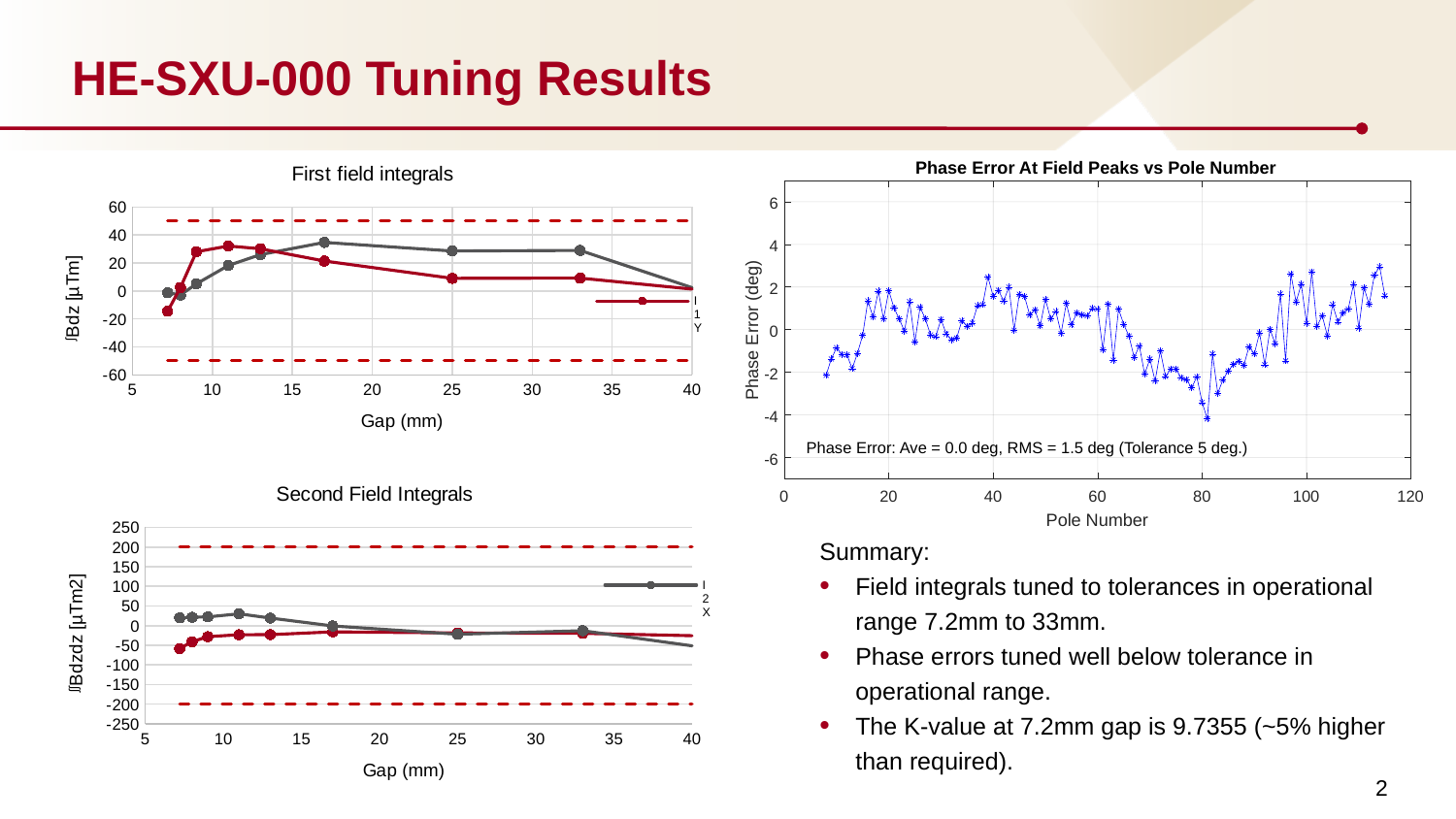
On the 'Phase Error At Field Peaks vs Pole Number' chart, what average phase error is stated in the annotation? 0.0 deg What is the x-axis label of the 'Second Field Integrals' chart? Gap (mm) On the 'First field integrals' chart, does the red series rise or fall between a gap of 11 mm and a gap of 40 mm? fall On the 'First field integrals' chart, at which y-axis values are the dashed red tolerance lines drawn? 50 and -50 On the 'Phase Error At Field Peaks vs Pole Number' chart, what RMS phase error is stated in the annotation? 1.5 deg On the 'First field integrals' chart, is the value of the red series at a gap of 7 mm greater or less than 0? less On the 'Phase Error At Field Peaks vs Pole Number' chart, what tolerance is stated in the annotation? 5 deg On the 'Phase Error At Field Peaks vs Pole Number' chart, is the phase error at pole number 81 greater or less than -2? less On the 'First field integrals' chart, is the value of the grey series at a gap of 17 mm greater or less than 20? greater What is the title of the chart on the right side of the slide? Phase Error At Field Peaks vs Pole Number What kind of chart is the 'First field integrals' chart? line chart On the 'Second Field Integrals' chart, at which y-axis values are the dashed red tolerance lines drawn? 200 and -200